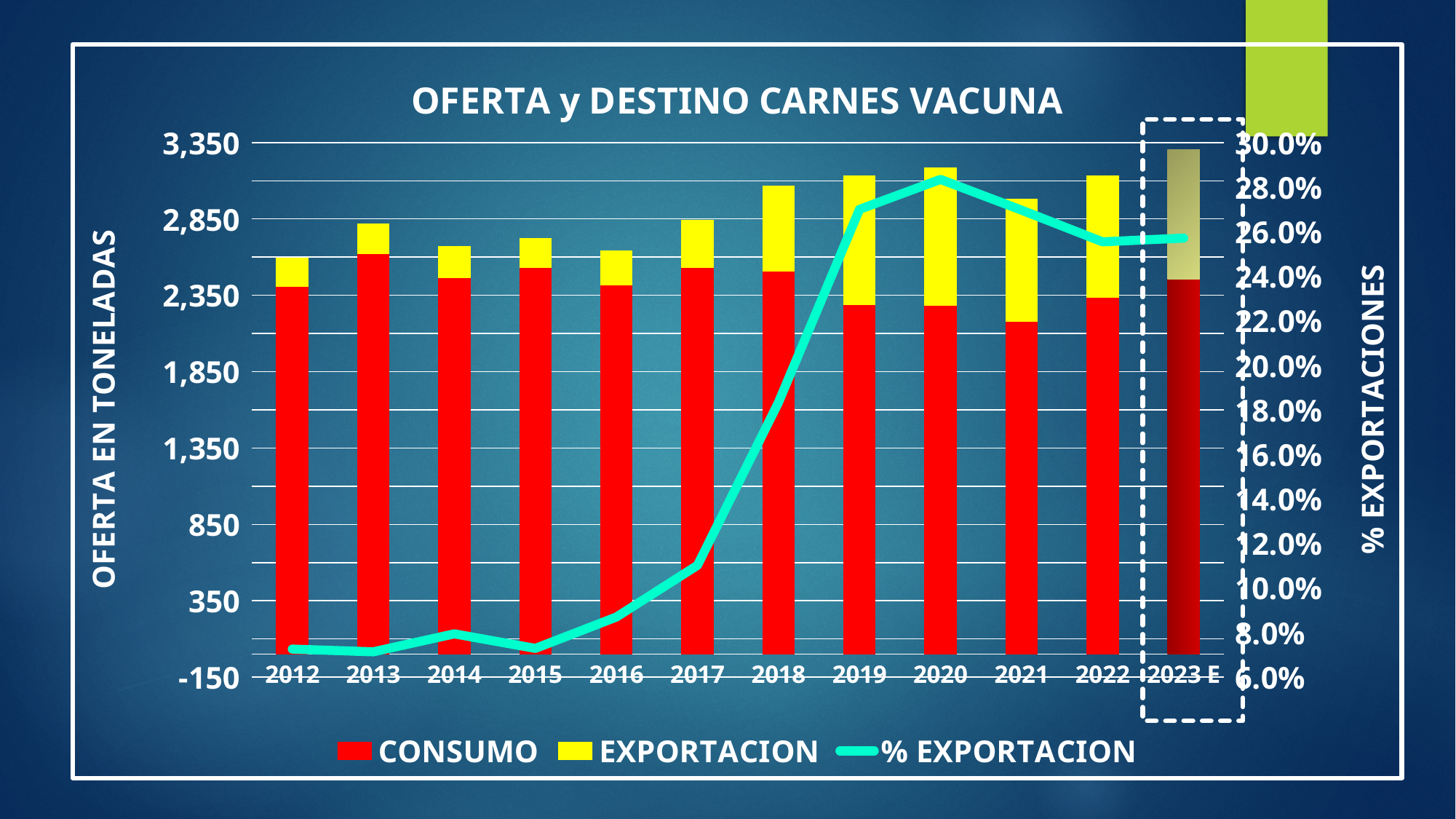
How many years are shown on the x axis? 12 How many series does the legend list? 3 Does the % EXPORTACION line rise or fall from 2016 to 2020? rise Is the % EXPORTACION value for 2012 greater or less than 10.0%? less What kind of chart is this? Stacked bar chart with a line What is the title of the chart? OFERTA y DESTINO CARNES VACUNA Which is larger, the CONSUMO value for 2013 or for 2021? 2013 Is the CONSUMO value for 2021 greater or less than 2,350? less Which year has the tallest total bar (CONSUMO plus EXPORTACION)? 2023 E Which year has the lowest CONSUMO value? 2021 Which year has the highest % EXPORTACION value? 2020 Is the % EXPORTACION value for 2020 greater or less than 26.0%? greater